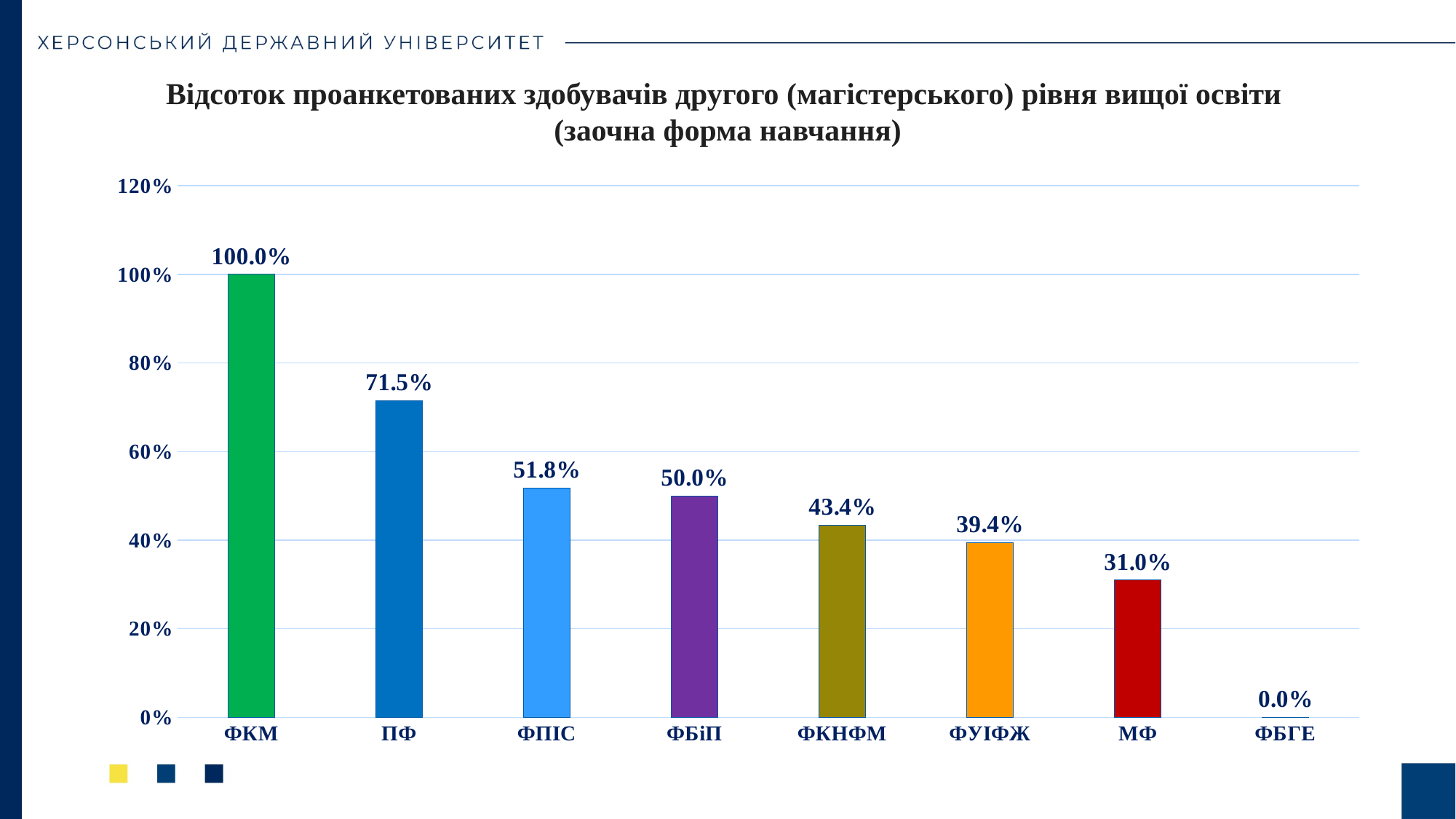
What is the value for МФ? 31.0% Which category has the lowest value? ФБГЕ What is the value for ПФ? 71.5% Do the values rise or fall from left to right along the x axis? fall Which category has the highest value? ФКМ What is the difference between the values for ФКМ and ПФ? 28.5% What is the value for ФКНФМ? 43.4% Which is larger, the value for ФУІФЖ or the value for МФ? ФУІФЖ What is the difference between the values for ФПІС and ФБіП? 1.8% Is the value for ФБіП greater or less than 40%? greater What kind of chart is shown on the slide? bar chart How many categories are shown on the x axis? 8